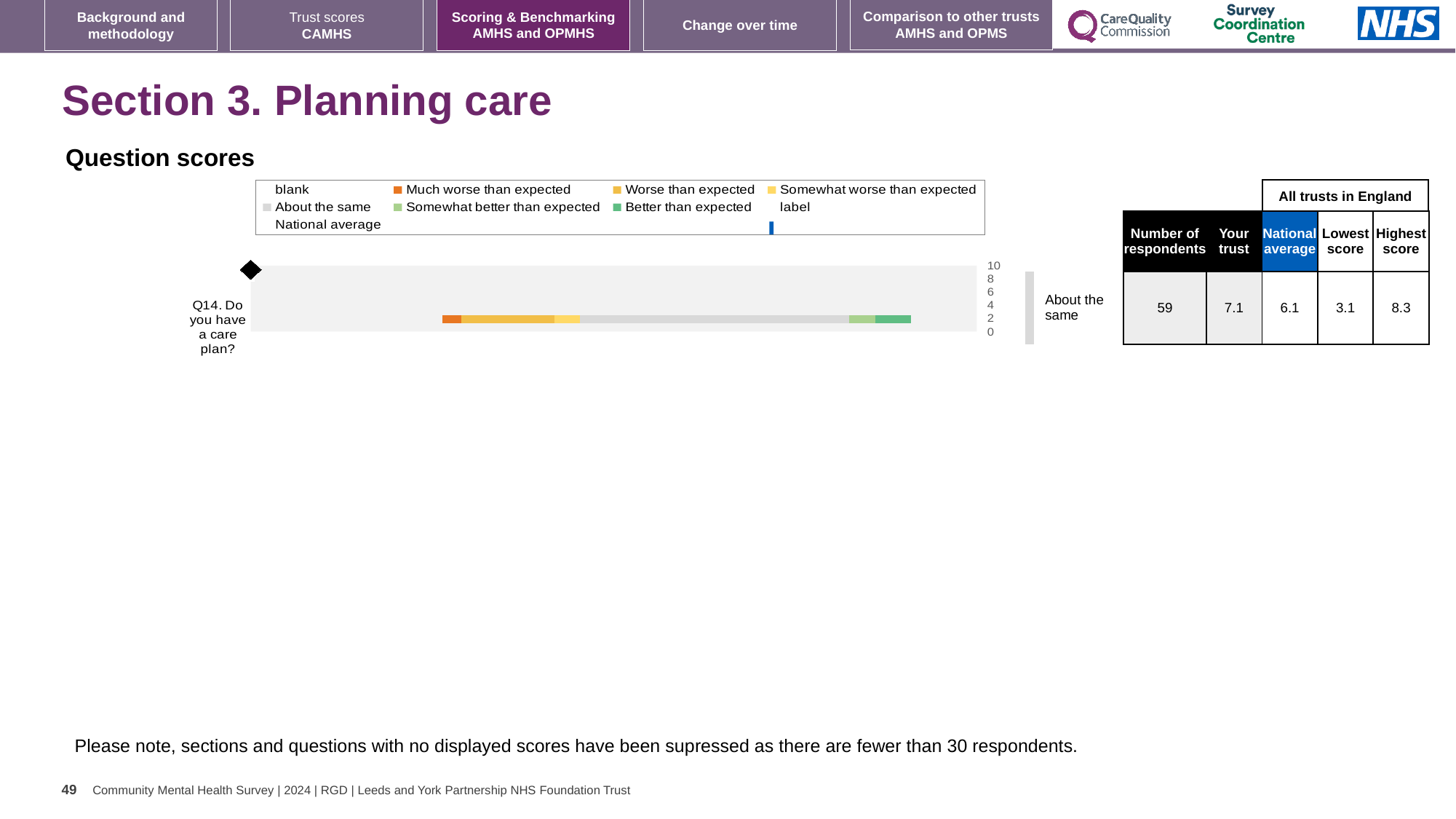
Which is larger for Q14, the 'Your trust' score or the national average? Your trust What is the difference between the highest and lowest scores among all trusts in England for Q14? 5.2 What is the 'Your trust' score for Q14? 7.1 What kind of chart is used to show the Q14 question score? bar chart Which question is plotted in the Question scores chart? Q14. Do you have a care plan? What benchmark category is shown next to the bar for Q14? About the same How many questions are plotted in the Question scores chart? 1 What is the highest score among all trusts in England for Q14? 8.3 How many respondents answered Q14? 59 What is the lowest score among all trusts in England for Q14? 3.1 What is the national average score for Q14? 6.1 What is the difference between the 'Your trust' score and the national average for Q14? 1.0